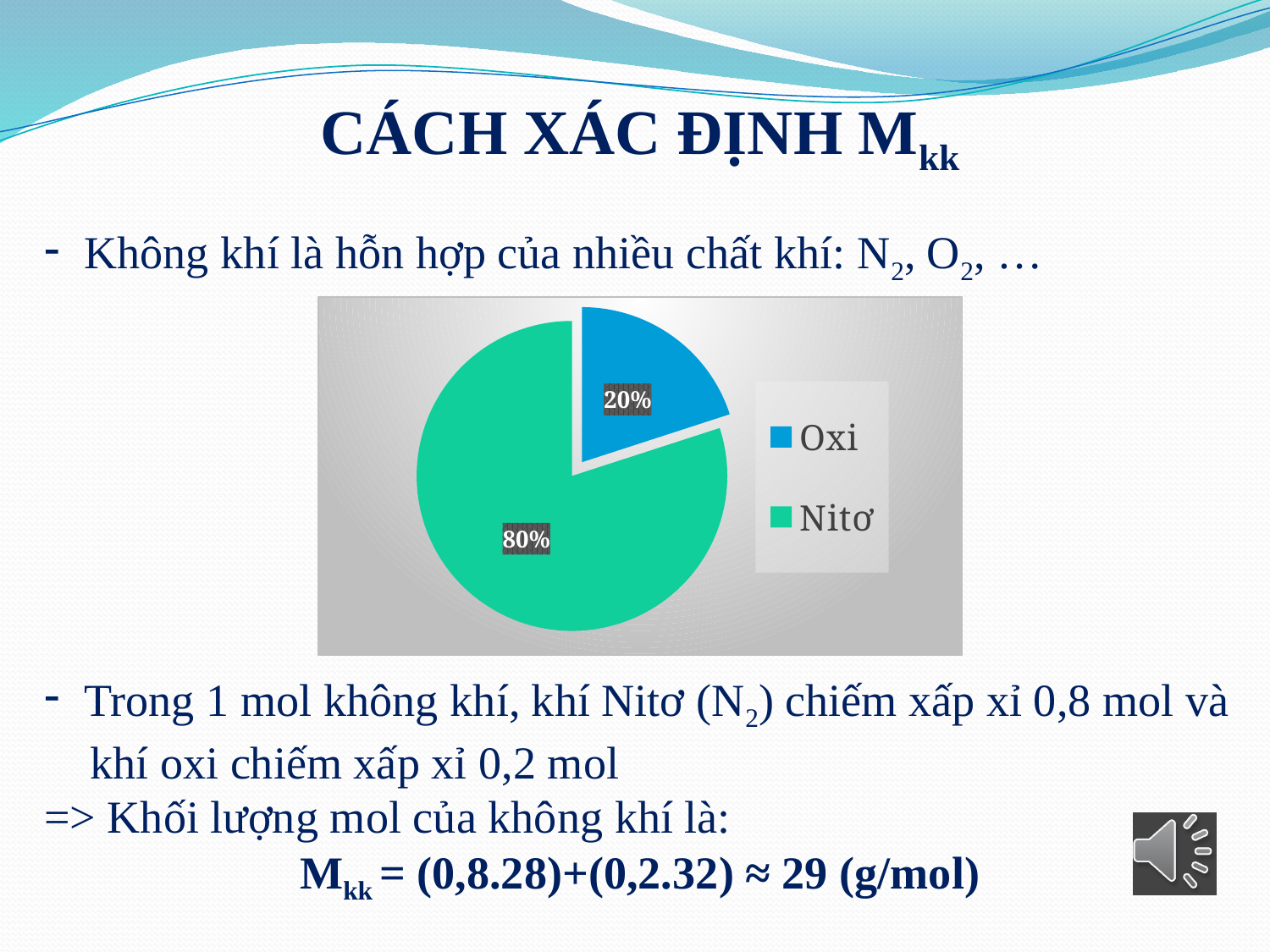
How many slices does the pie chart have? 2 Which is larger, the Oxi slice or the Nitơ slice? Nitơ What percentage does the Oxi slice show? 20% Which slice of the pie is the smallest? Oxi How many entries does the legend list? 2 Which slice of the pie is the largest? Nitơ What colour is the Oxi slice? blue Which slice is pulled out (exploded) from the pie? Oxi What share of the pie does Nitơ take? 80% What kind of chart is shown on the slide? pie chart What is the difference in percentage points between the Nitơ and Oxi slices? 60 What percentage does the Nitơ slice show? 80%